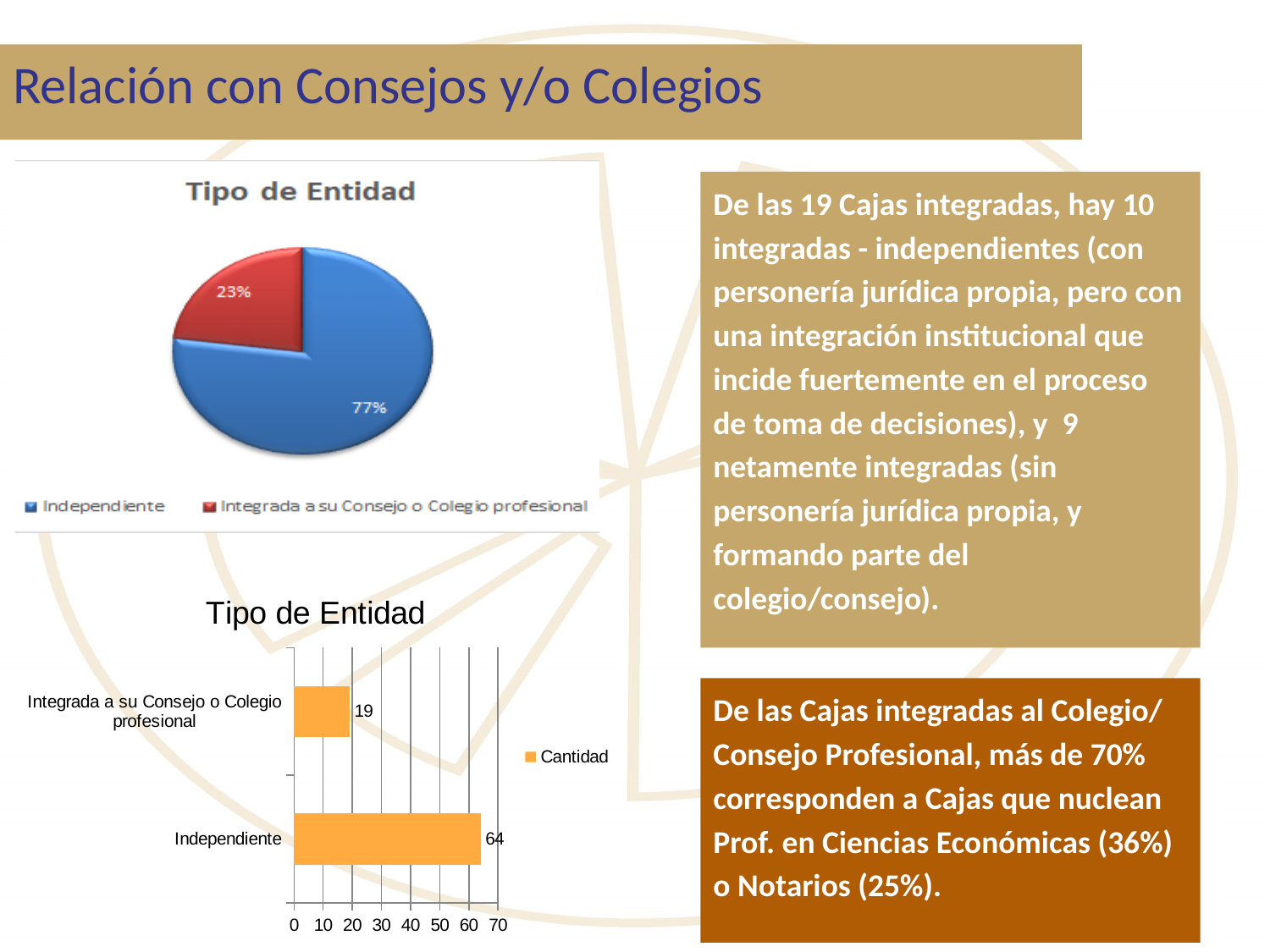
In the pie chart at the top left, what share does Integrada a su Consejo o Colegio profesional have? 23% In the bar chart at the bottom left, which category has the lowest value? Integrada a su Consejo o Colegio profesional In the bar chart at the bottom left, what is the value for Independiente? 64 In the pie chart at the top left, how many slices are there? 2 In the bar chart at the bottom left, what series name does the legend show? Cantidad What kind of chart is the bottom-left chart on the slide? Bar chart In the pie chart at the top left, which category has the largest slice? Independiente In the pie chart at the top left, what share does Independiente have? 77% In the bar chart at the bottom left, what is the difference between the values for Independiente and Integrada a su Consejo o Colegio profesional? 45 What kind of chart is the top-left chart on the slide? Pie chart In the bar chart at the bottom left, what is the value for Integrada a su Consejo o Colegio profesional? 19 In the bar chart at the bottom left, which is larger: the value for Independiente or for Integrada a su Consejo o Colegio profesional? Independiente